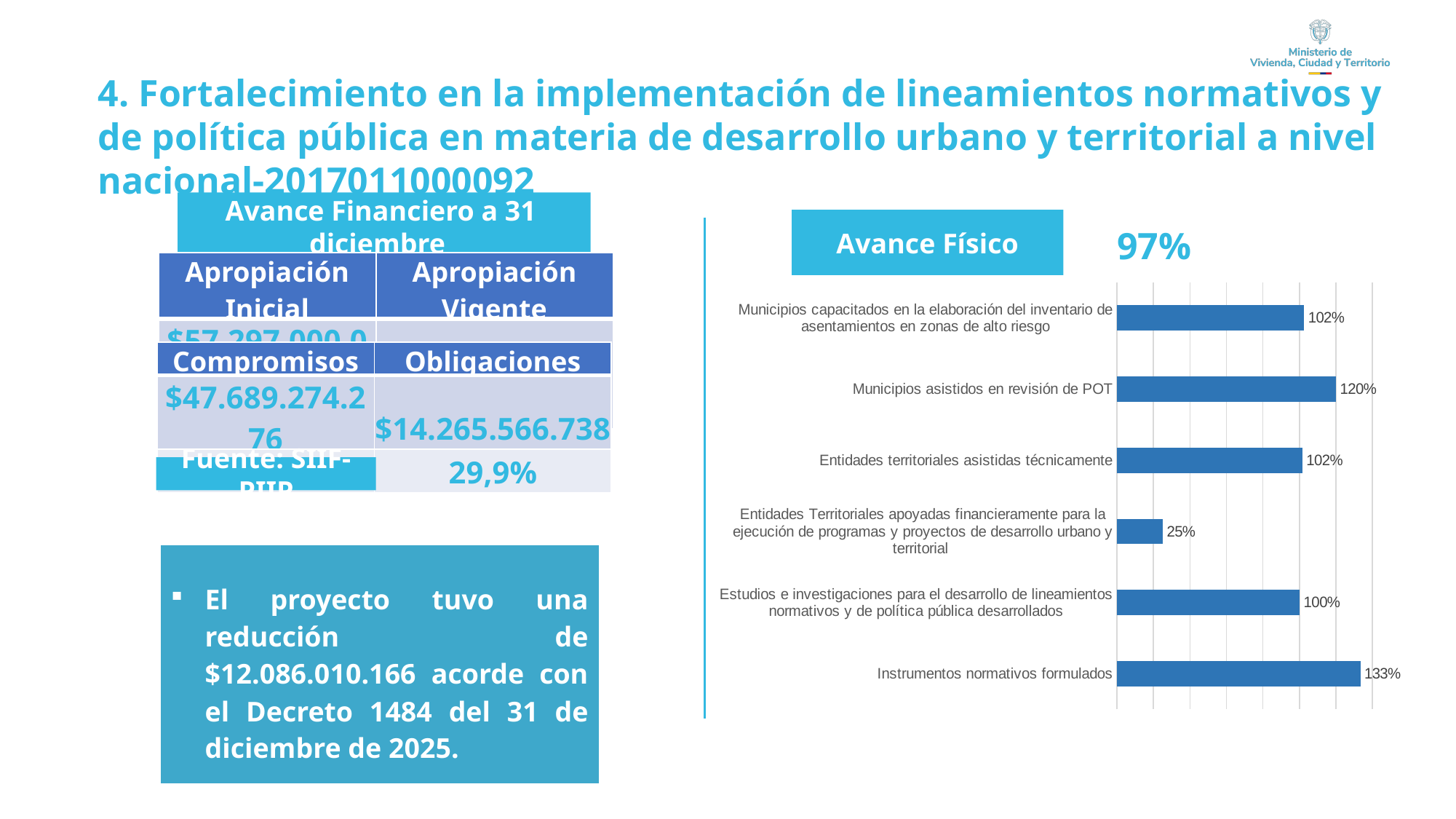
What is the value for "Municipios asistidos en revisión de POT"? 120% Which category has the lowest value in the bar chart? Entidades Territoriales apoyadas financieramente para la ejecución de programas y proyectos de desarrollo urbano y territorial What is the difference between the value for "Instrumentos normativos formulados" and the value for "Municipios asistidos en revisión de POT"? 13% What is the value for "Instrumentos normativos formulados"? 133% Which category has the highest value in the bar chart? Instrumentos normativos formulados What kind of chart is shown on the slide? Bar chart What is the value for "Entidades Territoriales apoyadas financieramente para la ejecución de programas y proyectos de desarrollo urbano y territorial"? 25% What is the value for "Municipios capacitados en la elaboración del inventario de asentamientos en zonas de alto riesgo"? 102% How many categories are shown in the bar chart? 6 What overall percentage is shown next to the "Avance Físico" heading above the chart? 97% What is the value for "Estudios e investigaciones para el desarrollo de lineamientos normativos y de política pública desarrollados"? 100% Which is larger: the value for "Municipios asistidos en revisión de POT" or the value for "Entidades territoriales asistidas técnicamente"? Municipios asistidos en revisión de POT